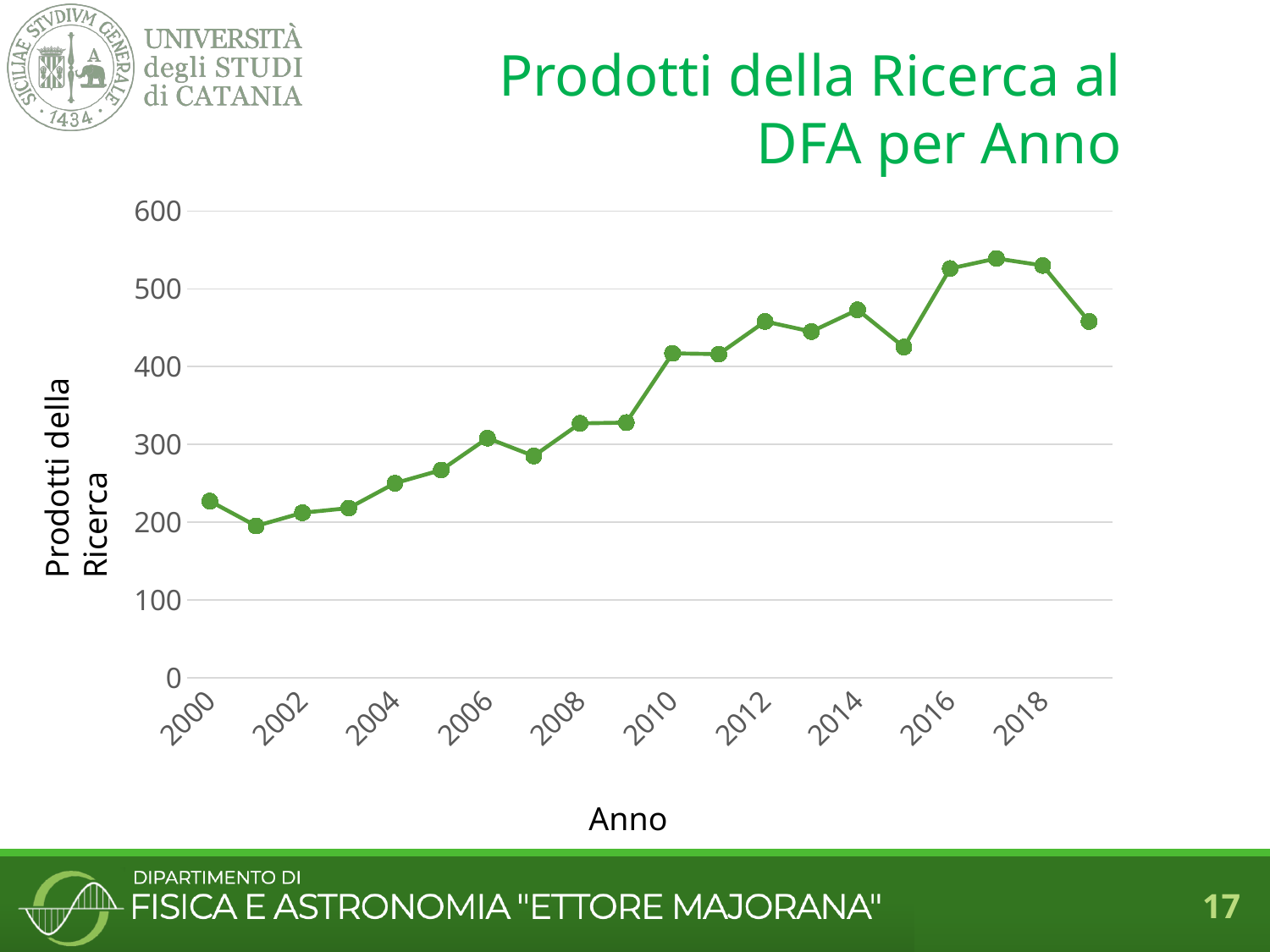
What kind of chart is shown on the slide? line chart Is the value for 2010 greater or less than 400? greater Which is larger, the value for 2015 or the value for 2016? 2016 What is the title of the chart? Prodotti della Ricerca al DFA per Anno Is the value for 2004 greater or less than 300? less What is the label of the x axis? Anno Which is larger, the value for 2000 or the value for 2010? 2010 How many data points are plotted on the line? 20 Which year has the lowest value? 2001 Is the value for 2016 greater or less than 500? greater Overall, do the values rise or fall from 2000 to 2018? rise